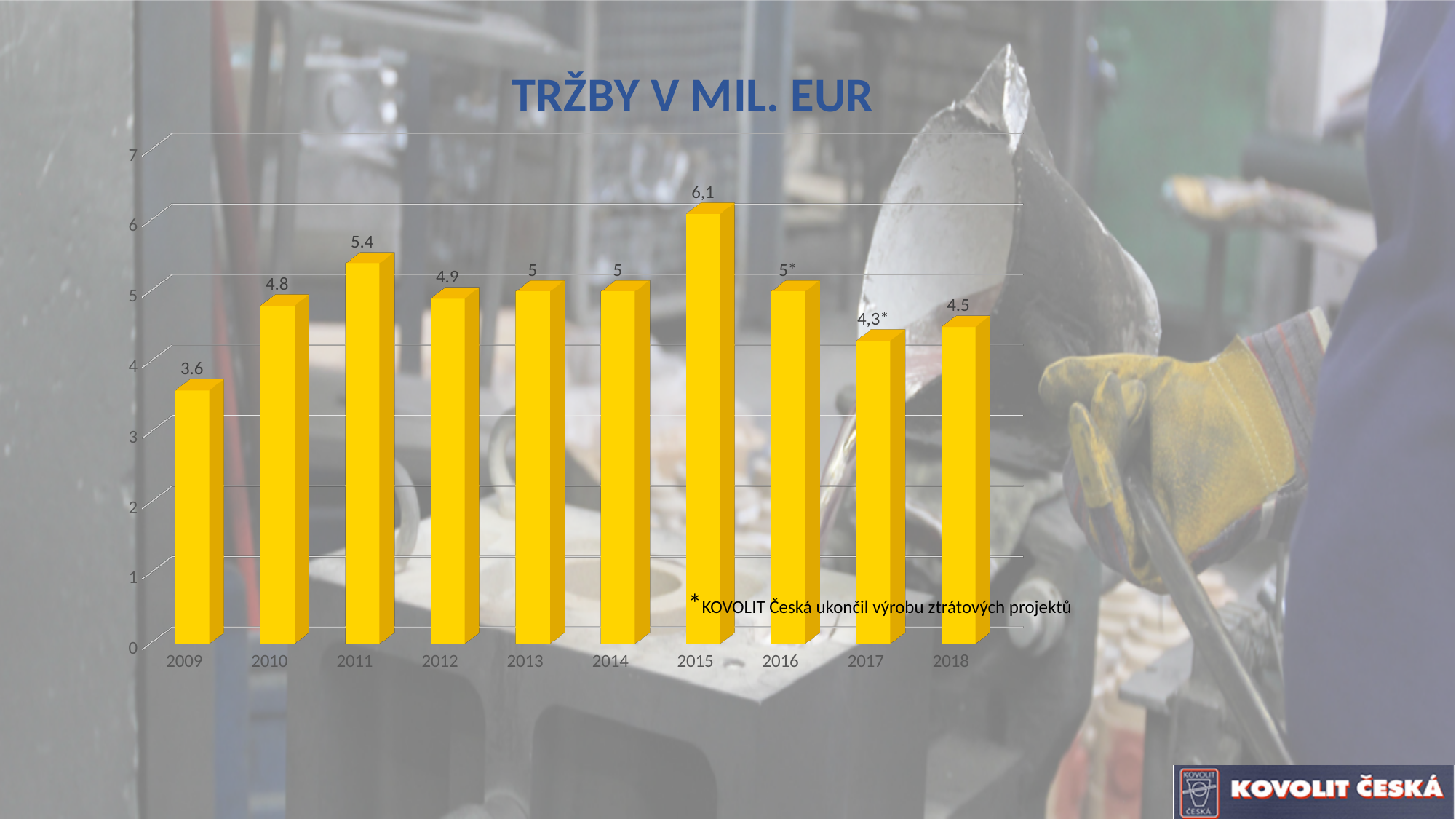
What is the chart's title? TRŽBY V MIL. EUR Which year has the highest value? 2015 What is the value for 2011? 5.4 What is the value for 2015? 6,1 Which year has the lowest value? 2009 How many years are shown on the x axis of the chart? 10 What is the difference between the values for 2011 and 2009? 1.8 What is the value for 2009? 3.6 What type of chart is shown on the slide? bar chart What is the value for 2018? 4.5 Which is larger, the value for 2010 or the value for 2012? 2012 Is the value for 2017 greater or less than 5? less